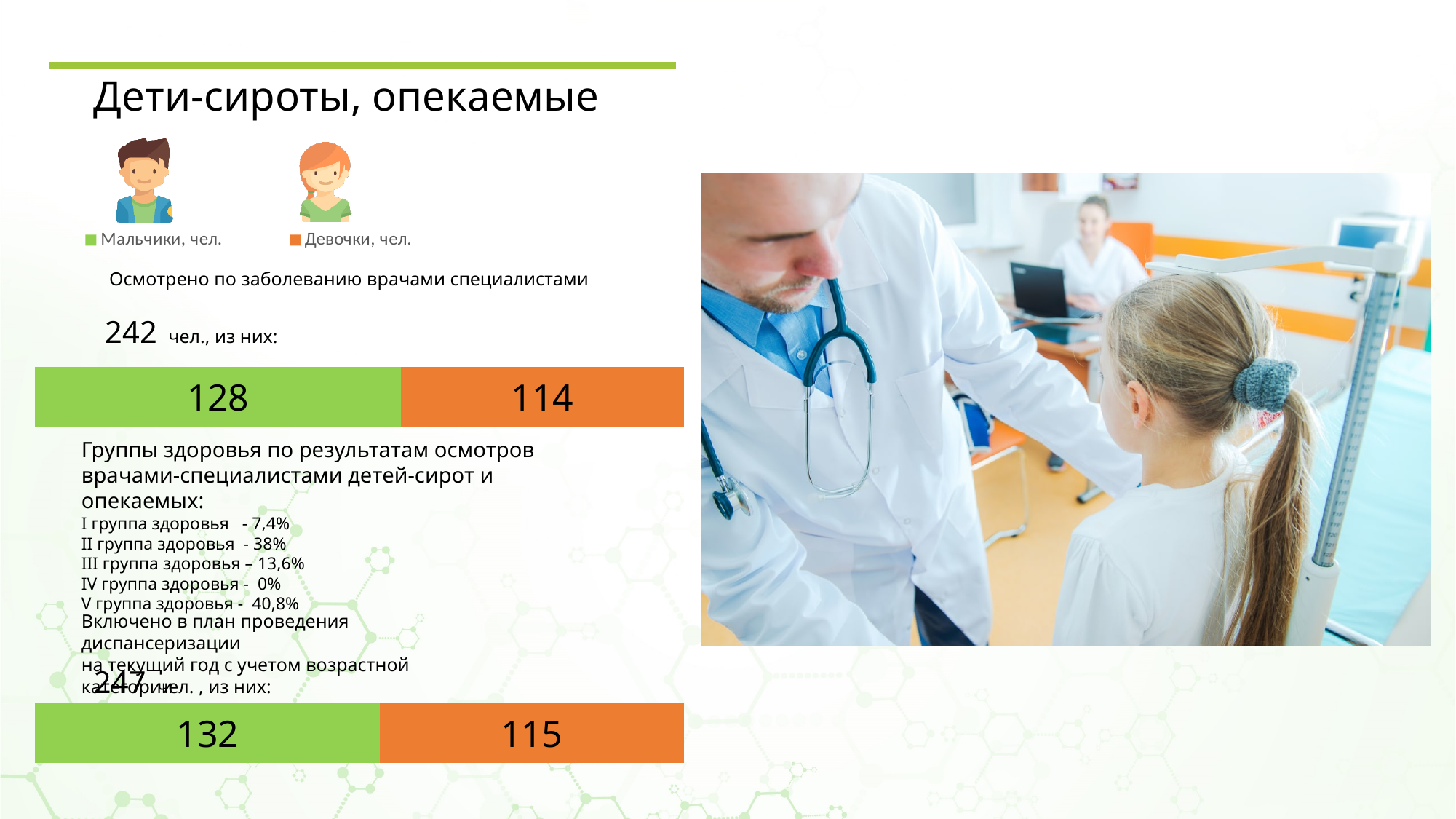
На верхней диаграмме «Осмотрено по заболеванию врачами специалистами» кого больше — мальчиков или девочек? Мальчиков На нижней диаграмме «Включено в план проведения диспансеризации» сколько мальчиков? 132 На верхней диаграмме «Осмотрено по заболеванию врачами специалистами» сколько девочек? 114 На нижней диаграмме «Включено в план проведения диспансеризации» на сколько мальчиков больше, чем девочек? 17 Какого типа диаграммы на слайде? Линейчатая (столбчатая) диаграмма с накоплением На верхней диаграмме «Осмотрено по заболеванию врачами специалистами» сколько мальчиков? 128 На верхней диаграмме «Осмотрено по заболеванию врачами специалистами» на сколько мальчиков больше, чем девочек? 14 На верхней диаграмме «Осмотрено по заболеванию врачами специалистами» чему равна сумма значений полосы? 242 На нижней диаграмме «Включено в план проведения диспансеризации» чему равна сумма значений полосы? 247 Каким цветом на диаграммах обозначены девочки? Оранжевым Сколько серий указано в легенде диаграмм на слайде? 2 На нижней диаграмме «Включено в план проведения диспансеризации» сколько девочек? 115